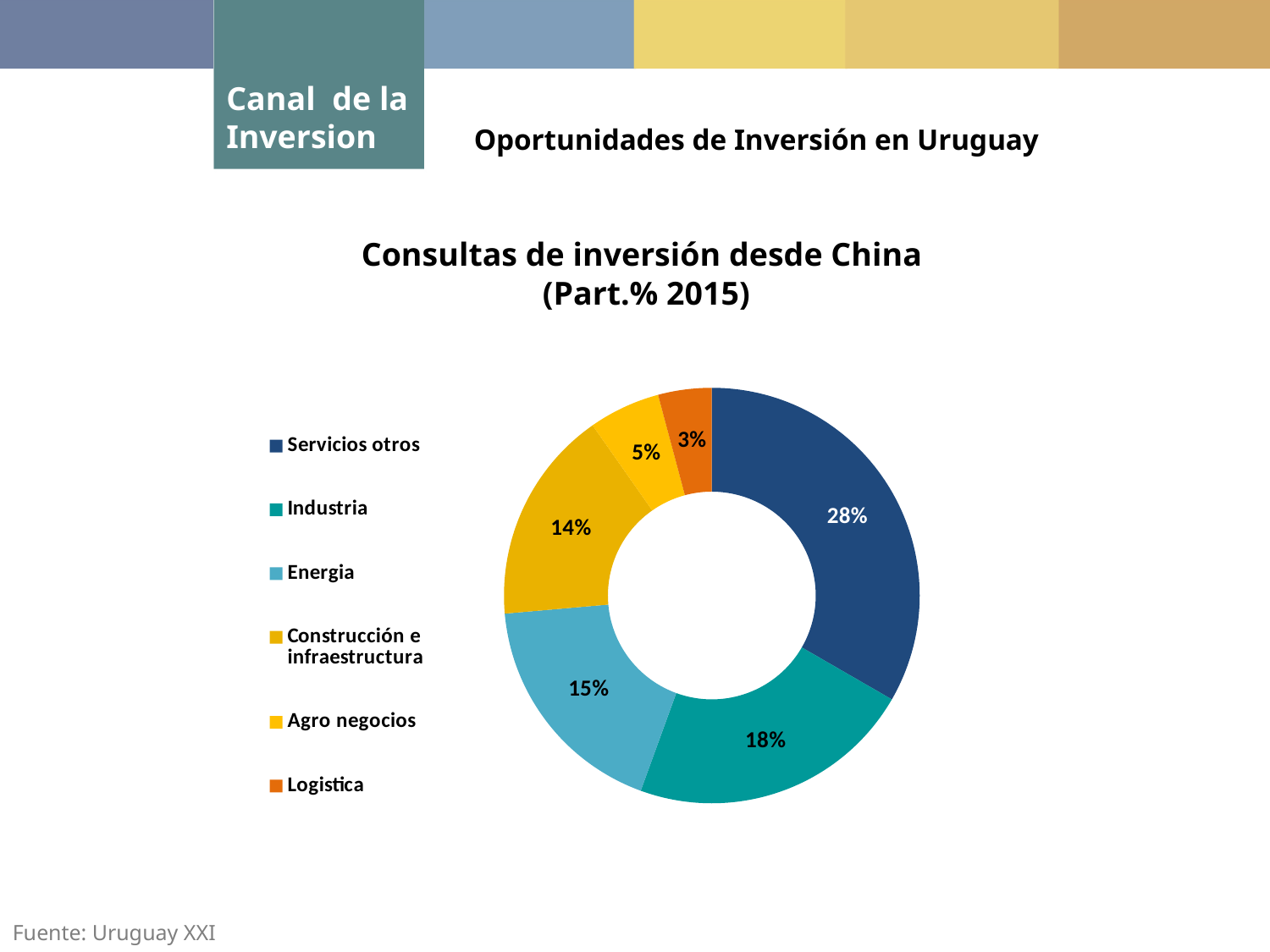
What is the value shown for Logistica? 3% What is the title of the chart? Consultas de inversión desde China (Part.% 2015) Which category has the smallest share? Logistica What kind of chart is shown on the slide? Doughnut (pie) chart How many categories does the chart show? 6 What is the value shown for Energia? 15% What is the difference between the shares of Servicios otros and Industria? 10% What is the value shown for Industria? 18% What is the value shown for Construcción e infraestructura? 14% Which is larger, Agro negocios or Logistica? Agro negocios What share of the chart does Servicios otros have? 28% Which category has the largest share? Servicios otros